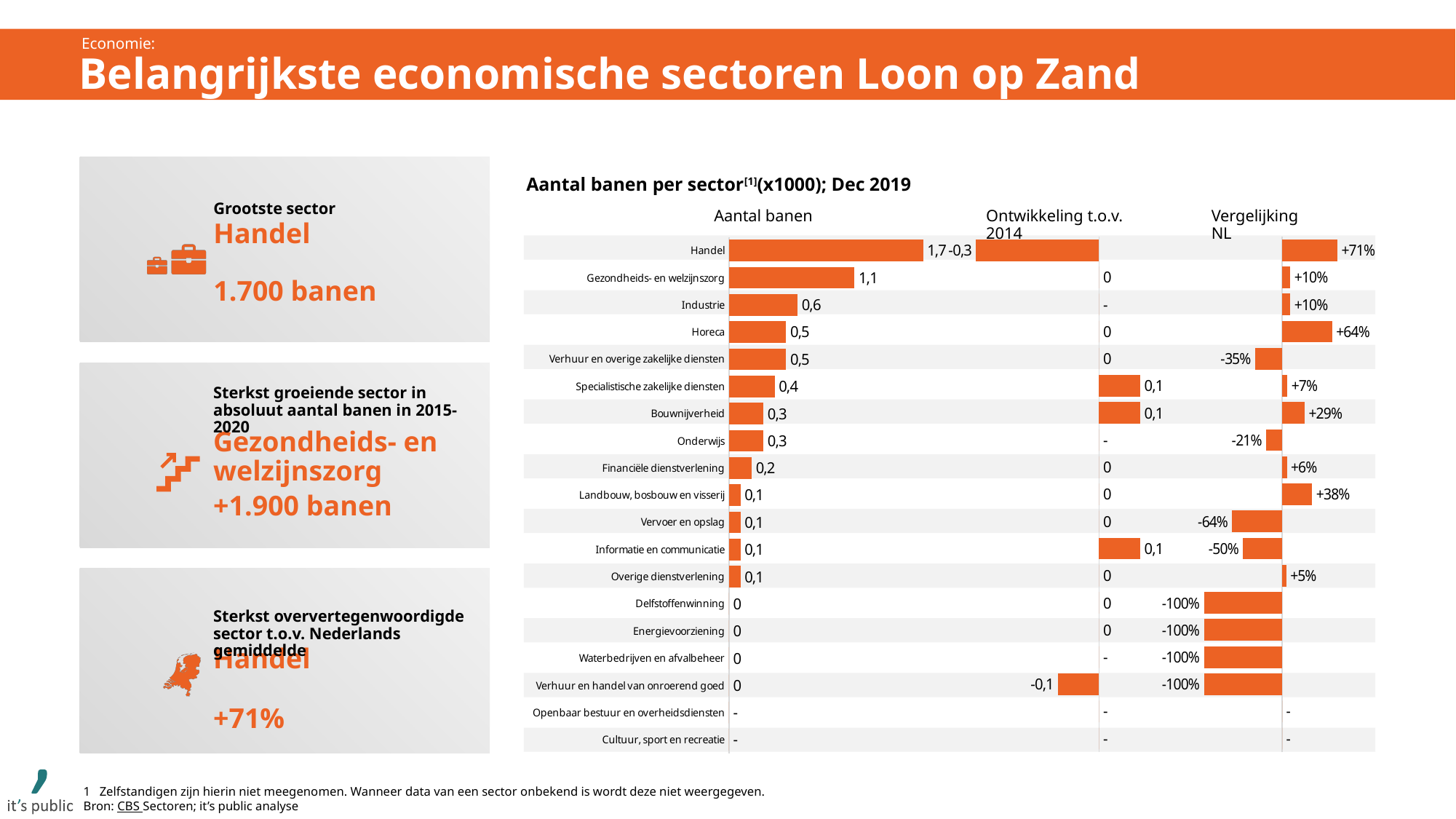
In the 'Vergelijking NL' column, which is larger: Landbouw, bosbouw en visserij or Bouwnijverheid? Landbouw, bosbouw en visserij In the 'Vergelijking NL' column, what is the value for Vervoer en opslag? -64% In the 'Aantal banen' column, which is larger: Industrie or Bouwnijverheid? Industrie In the 'Vergelijking NL' column, what is the value for Horeca? +64% In the 'Aantal banen' column, what is the value for Gezondheids- en welzijnszorg? 1,1 In the 'Ontwikkeling t.o.v. 2014' column, what is the value for Handel? -0,3 In the 'Aantal banen' column, what is the value for Handel? 1,7 How many sectors are listed in the chart? 19 Which sector has the highest value in the 'Aantal banen' column? Handel What type of chart is used to show the 'Aantal banen' values? Bar chart What is the difference between the 'Aantal banen' values for Handel and Gezondheids- en welzijnszorg? 0,6 Which sector has the highest value in the 'Vergelijking NL' column? Handel